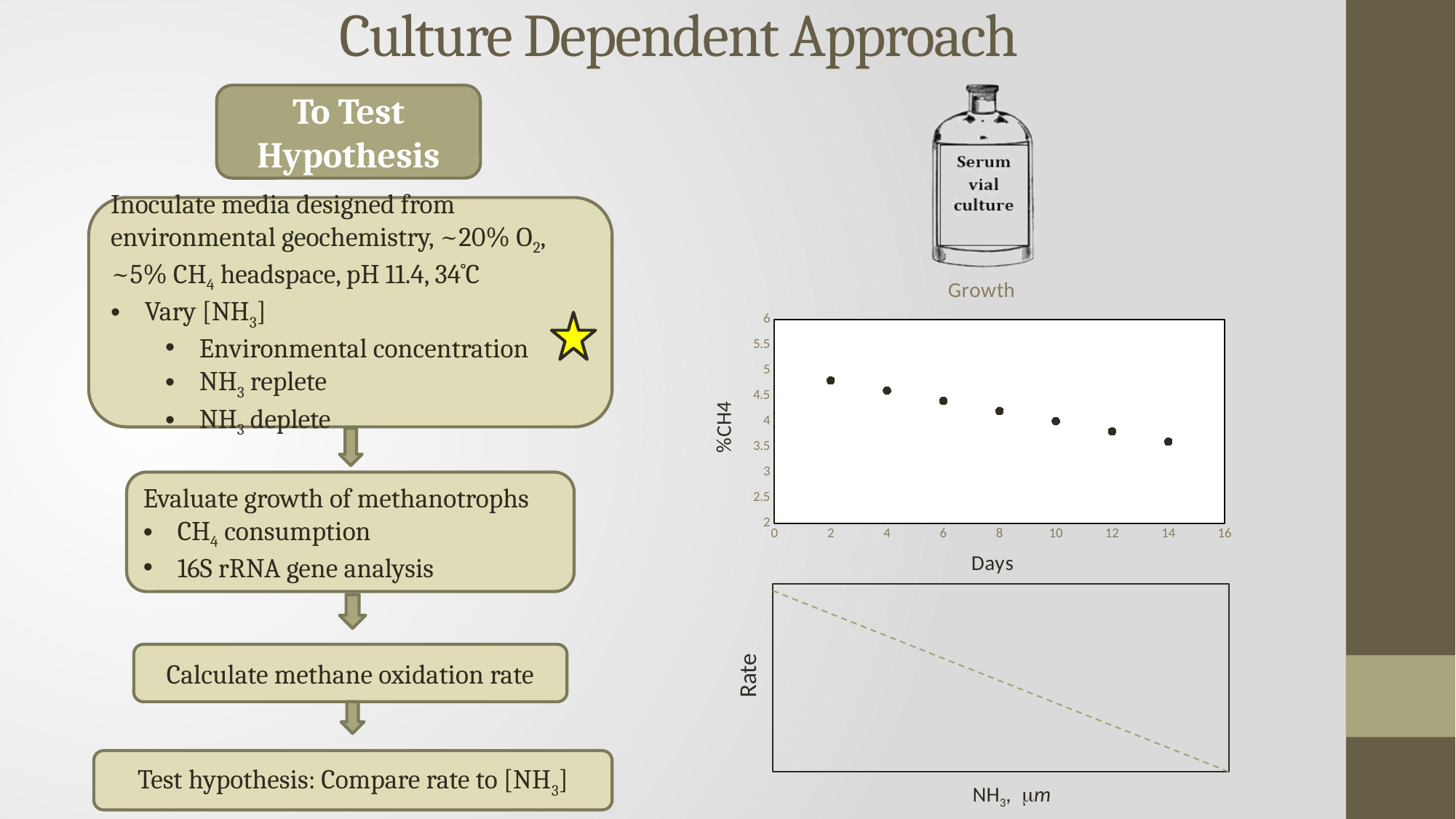
In the 'Growth' chart, do the %CH4 values rise or fall as Days increase? fall In the 'Growth' chart, which has the larger %CH4 value, day 4 or day 10? day 4 What kind of chart is the 'Growth' chart on the slide? scatter chart In the 'Growth' chart, at which day is %CH4 lowest? 14 In the bottom-right chart of Rate versus NH3, does the dashed line rise or fall as NH3 increases? fall What is the label of the y-axis in the 'Growth' chart? %CH4 In the 'Growth' chart, is the %CH4 value at day 2 greater or less than 4.5? greater What is the label of the x-axis in the 'Growth' chart? Days In the 'Growth' chart, is the %CH4 value at day 14 greater or less than 4? less In the 'Growth' chart, is the %CH4 value at day 12 greater or less than 4? less How many data points are plotted in the 'Growth' chart? 7 In the 'Growth' chart, at which day is %CH4 highest? 2